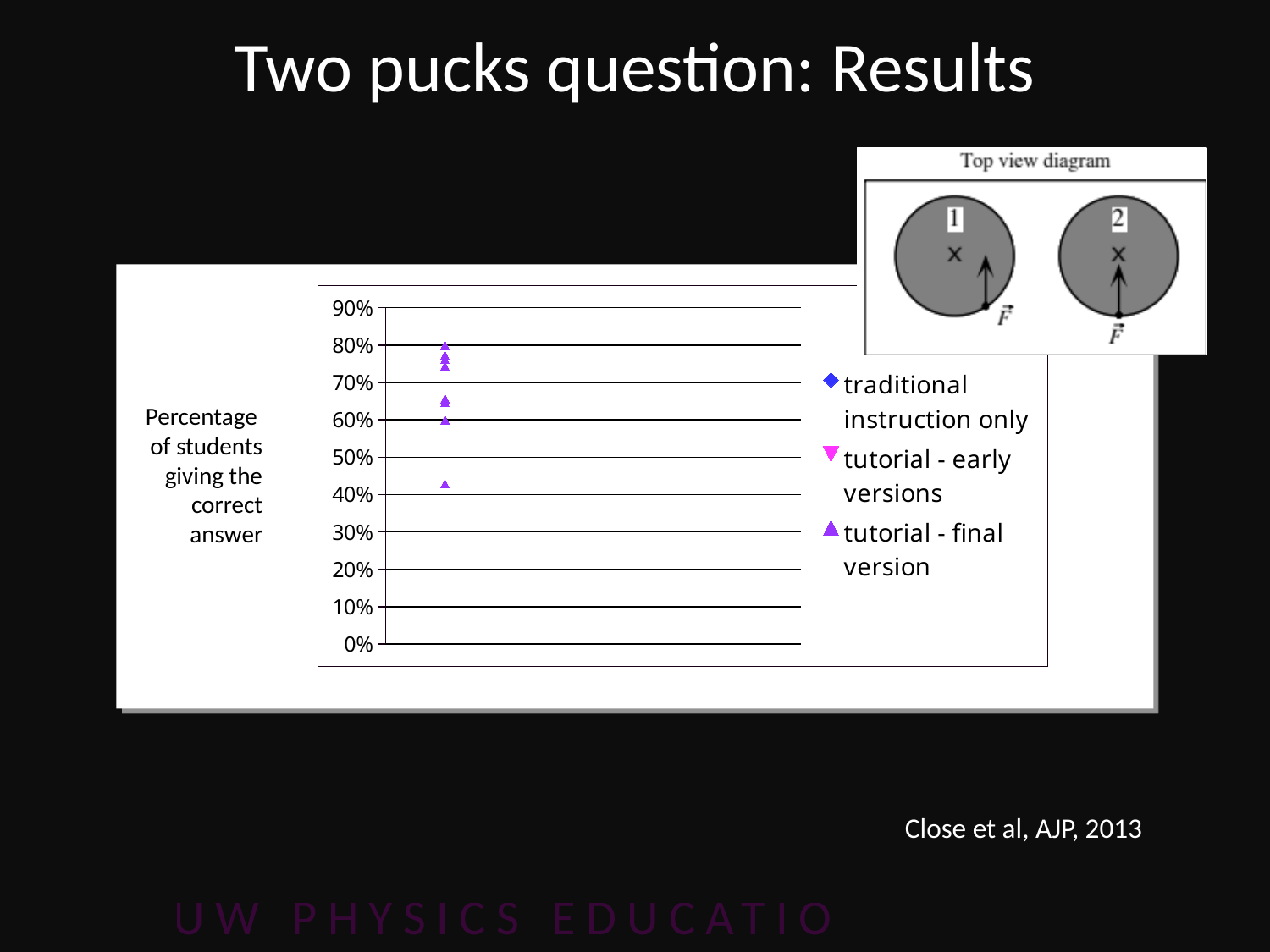
What kind of chart is shown on the slide? scatter chart Which legend series is represented by an upward-pointing triangle marker? tutorial - final version What is the title of the slide containing the chart? Two pucks question: Results What does the vertical axis of the chart represent, according to the label to its left? Percentage of students giving the correct answer Is the lowest plotted point on the chart greater or less than 50%? less Is the highest plotted point on the chart greater or less than 90%? less Which legend series is represented by a diamond marker? traditional instruction only What is the highest value shown on the chart's vertical axis? 90% How many series does the chart legend list? 3 Is the highest plotted point on the chart greater or less than 70%? greater